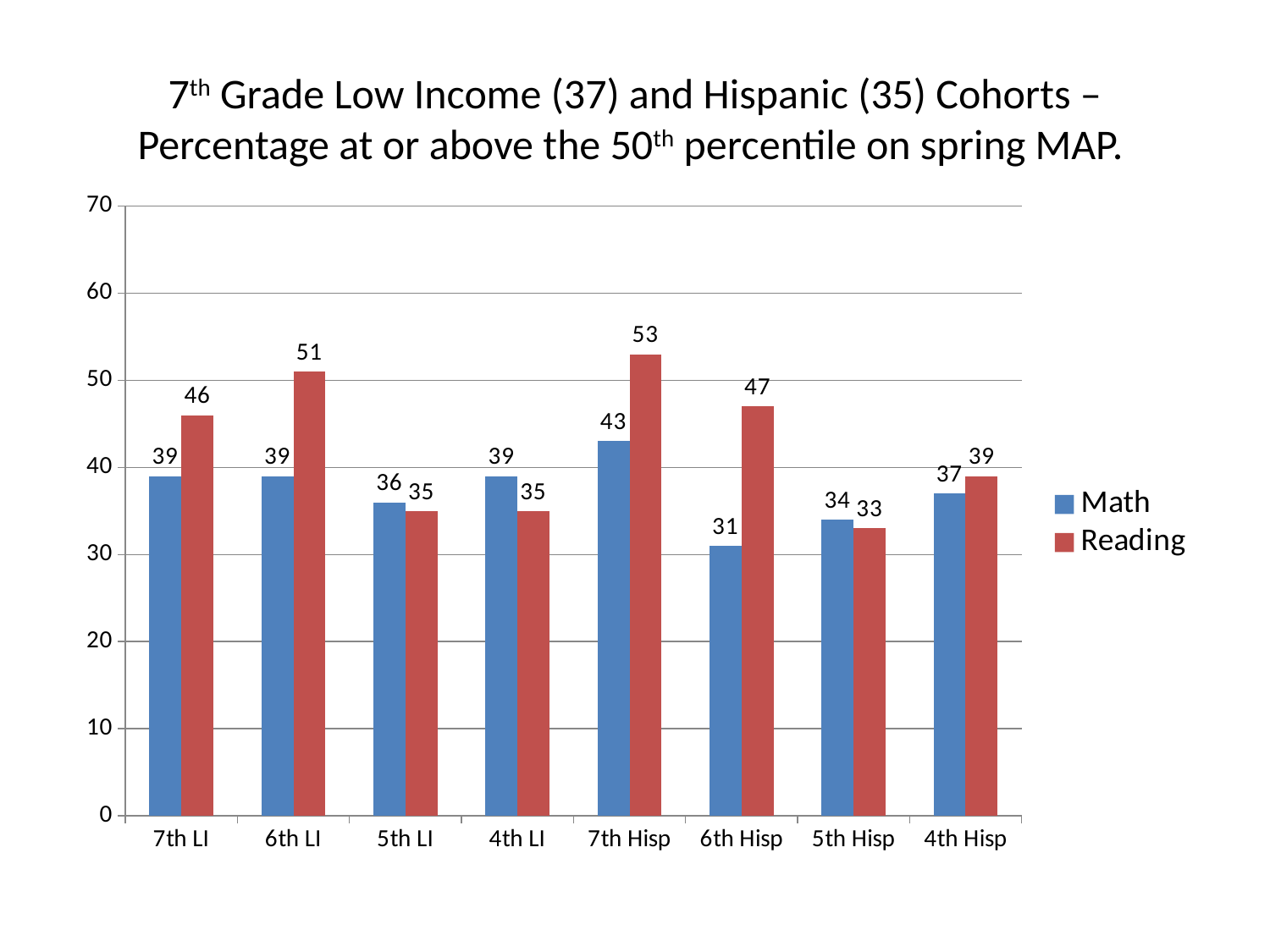
Which category has the highest Reading value? 7th Hisp For 5th Hisp, which is larger, Math or Reading? Math Is the Reading value for 7th Hisp greater or less than 50? greater What is the Reading value for 6th LI? 51 What colour represents the Reading series? red How many categories are shown on the x axis? 8 What is the Math value for 7th Hisp? 43 What kind of chart is shown? bar chart What is the Math value for 6th Hisp? 31 How many series does the legend list? 2 Which category has the lowest Math value? 6th Hisp What is the difference between the Reading and Math values for 6th Hisp? 16